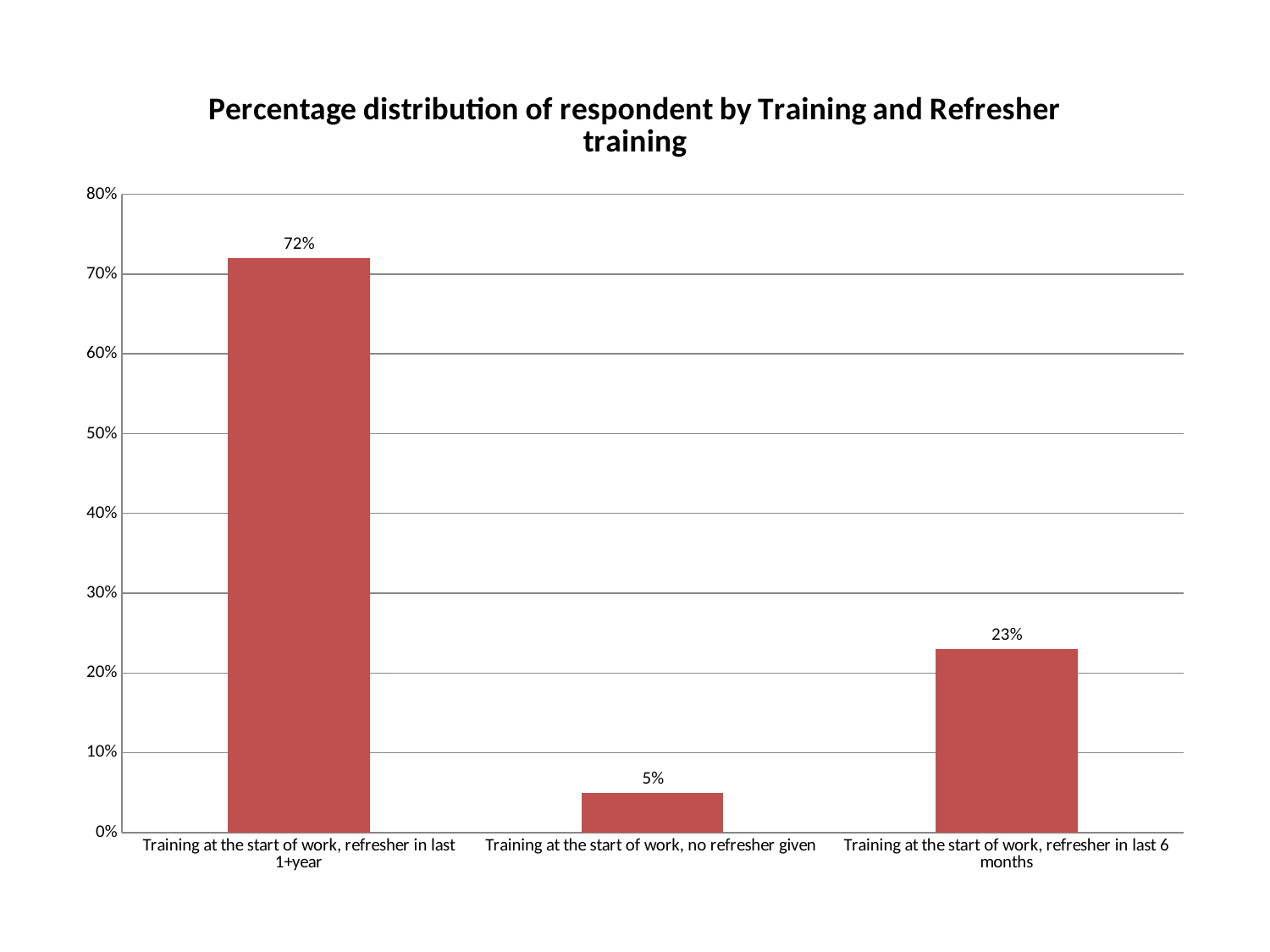
How many categories are shown on the chart? 3 What is the difference in percentage points between the 'refresher in last 6 months' category and the 'no refresher given' category? 18 percentage points Which category has the highest percentage of respondents? Training at the start of work, refresher in last 1+year Which is larger: the percentage for 'refresher in last 6 months' or for 'no refresher given'? Training at the start of work, refresher in last 6 months What is the title of the chart? Percentage distribution of respondent by Training and Refresher training What percentage of respondents had training at the start of work with a refresher in the last 1+ year? 72% What is the difference in percentage points between the 'refresher in last 1+year' category and the 'refresher in last 6 months' category? 49 percentage points What percentage of respondents had training at the start of work with a refresher in the last 6 months? 23% Which category has the lowest percentage of respondents? Training at the start of work, no refresher given What kind of chart is shown on the slide? Bar chart Is the value for 'Training at the start of work, refresher in last 1+year' greater or less than 70%? greater What percentage of respondents had training at the start of work with no refresher given? 5%